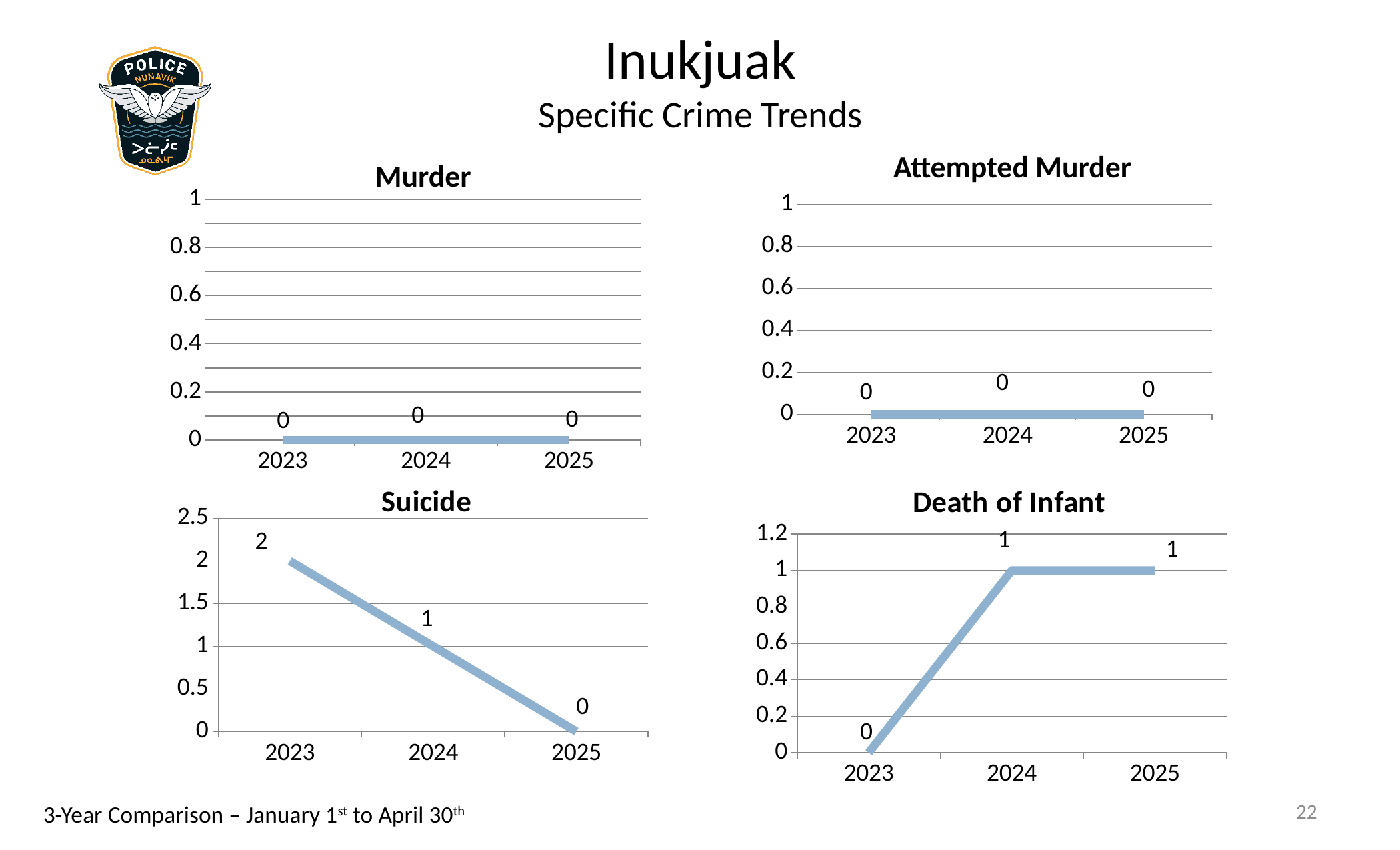
In the Death of Infant chart, which year has the lowest value? 2023 In the Murder chart, what is the value for 2024? 0 In the Suicide chart, what is the value for 2024? 1 In the Death of Infant chart, which is larger, the value for 2023 or the value for 2024? 2024 In the Death of Infant chart, what is the value for 2023? 0 In the Suicide chart, do the values rise or fall from 2023 to 2025? fall What kind of chart is the Death of Infant chart? line chart In the Suicide chart, what is the value for 2023? 2 In the Suicide chart, what is the difference between the 2023 and 2025 values? 2 In the Suicide chart, which year has the highest value? 2023 How many years are plotted in the Attempted Murder chart? 3 In the Death of Infant chart, what is the value for 2025? 1